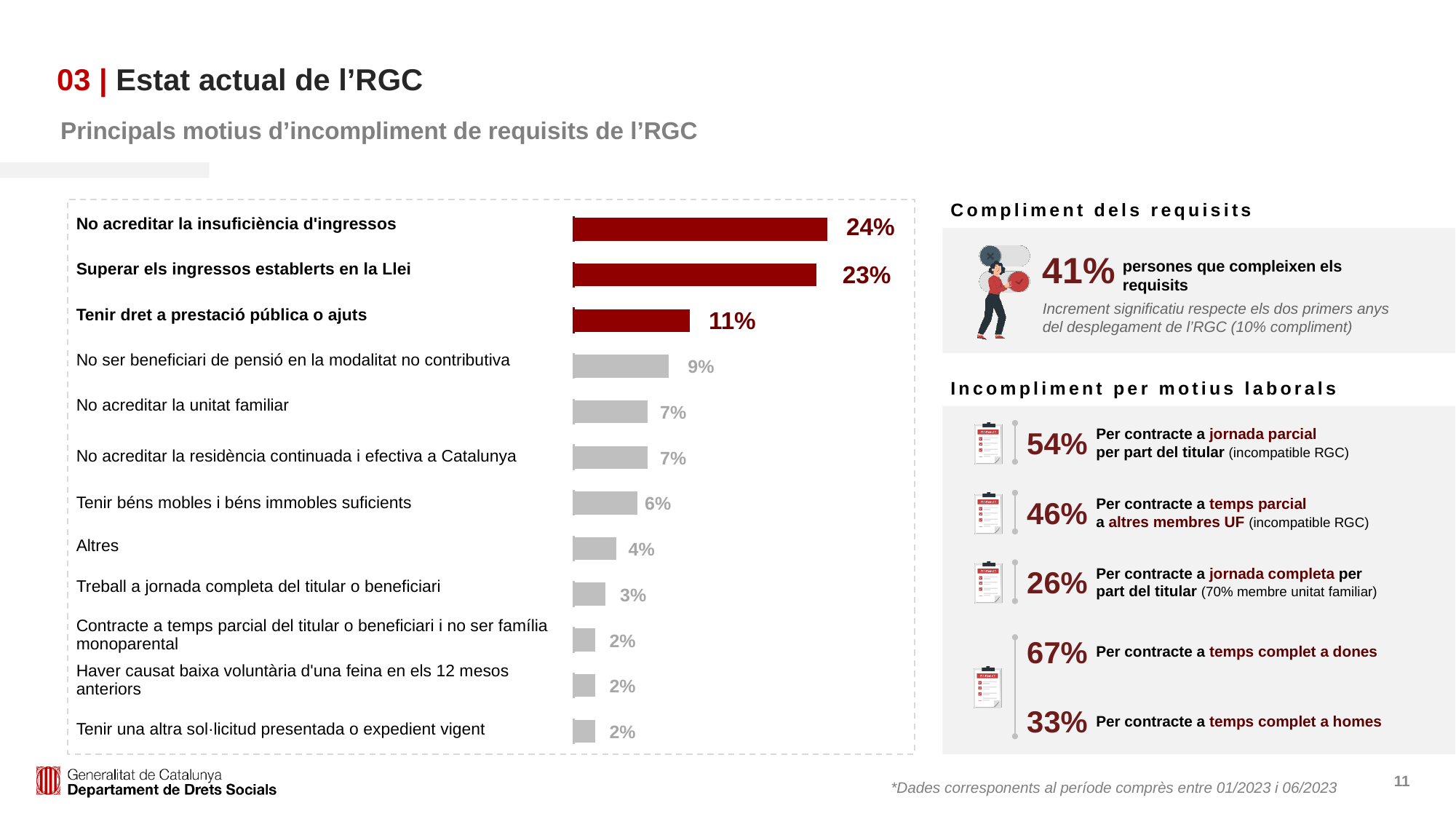
How many categories in the chart are highlighted with dark red bars? 3 What is the value for "Treball a jornada completa del titular o beneficiari"? 3% What is the difference between the values for "Superar els ingressos establerts en la Llei" and "Tenir dret a prestació pública o ajuts"? 12% What is the value for "Tenir dret a prestació pública o ajuts"? 11% What percentage is shown for "No acreditar la insuficiència d'ingressos"? 24% What kind of chart is shown on the slide? Bar chart Which category has the highest value in the chart? No acreditar la insuficiència d'ingressos Which is larger: the value for "Tenir béns mobles i béns immobles suficients" or the value for "Altres"? Tenir béns mobles i béns immobles suficients What is the value for "Altres"? 4% What percentage is shown for "No ser beneficiari de pensió en la modalitat no contributiva"? 9% What is the difference between the values for "No acreditar la insuficiència d'ingressos" and "Superar els ingressos establerts en la Llei"? 1% How many categories are shown in the bar chart? 12